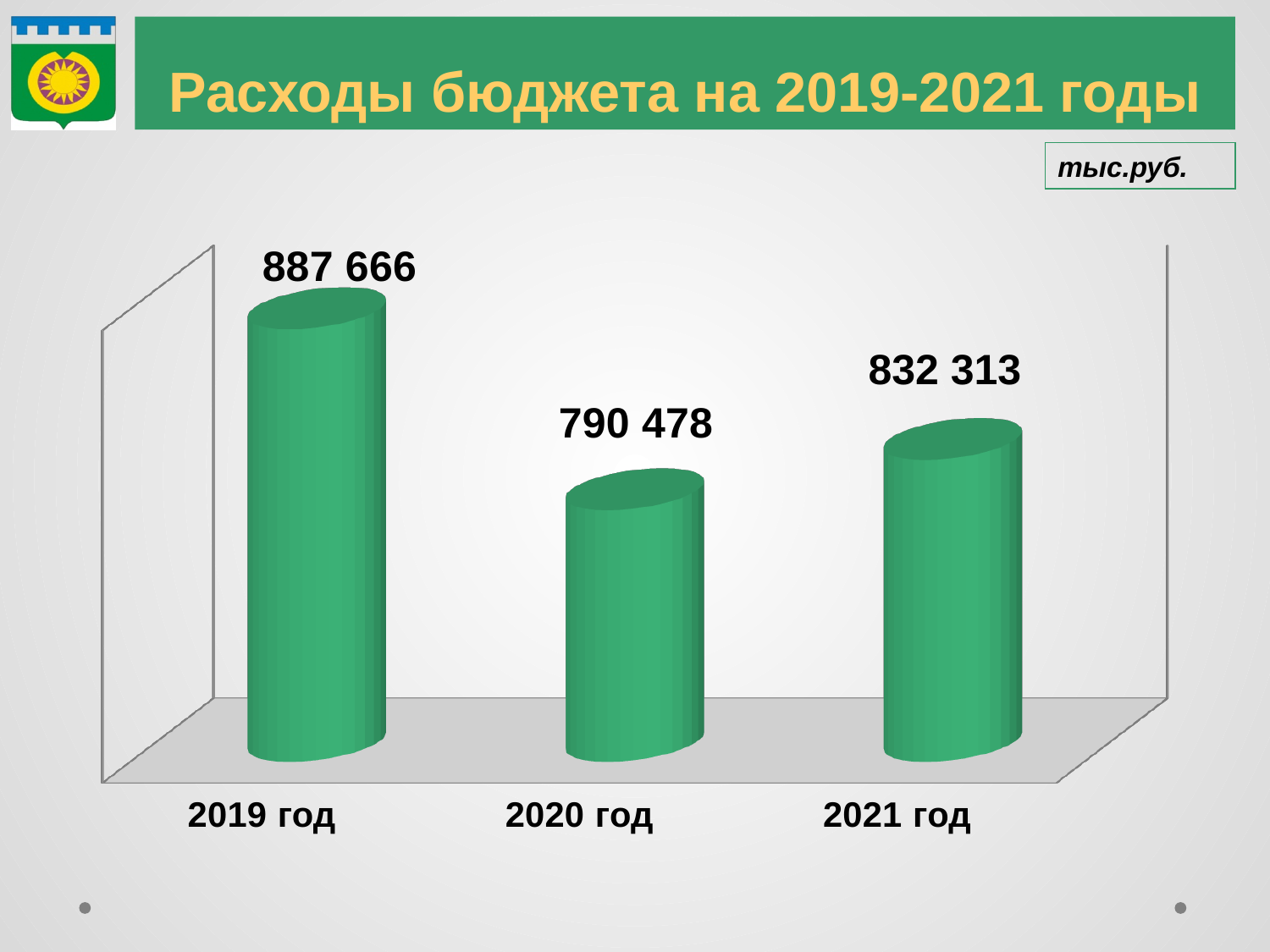
Which is larger, the value for 2021 год or the value for 2020 год? 2021 год What is the value for 2020 год? 790 478 What is the difference between the values for 2021 год and 2020 год? 41 835 Which year has the lowest budget expenditure? 2020 год In what units are the values on the chart given? тыс.руб. What kind of chart is shown on the slide? bar chart Does the value rise or fall from 2019 год to 2020 год? fall How many years are shown in the chart? 3 What is the value for 2021 год? 832 313 Which year has the highest budget expenditure? 2019 год What is the value for 2019 год? 887 666 What is the difference between the values for 2019 год and 2020 год? 97 188